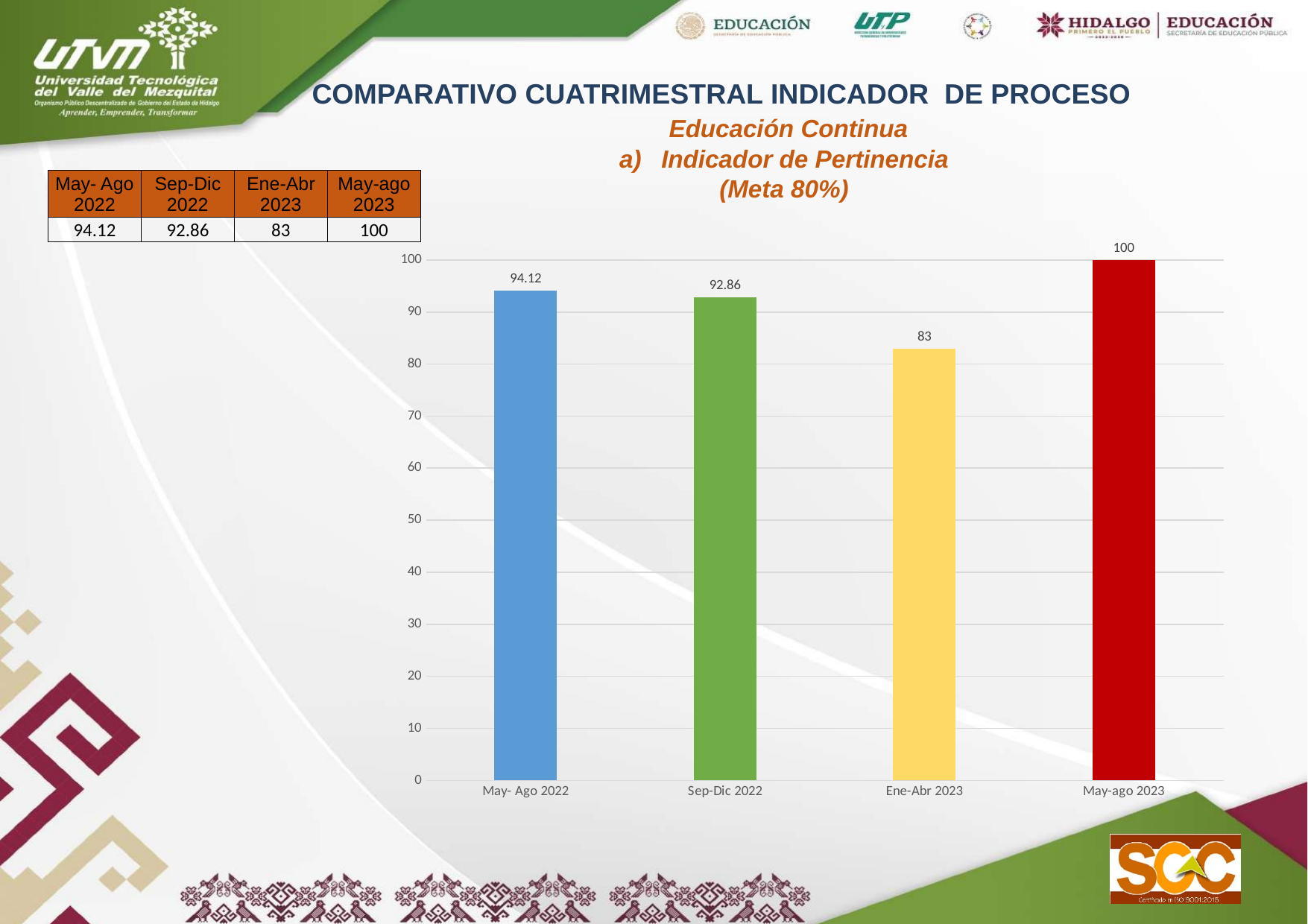
What is the difference between the values for May- Ago 2022 and Sep-Dic 2022? 1.26 What is the value for Sep-Dic 2022? 92.86 How many periods are shown on the chart? 4 Which period has the highest value? May-ago 2023 What is the difference between the values for May-ago 2023 and Ene-Abr 2023? 17 Which period has the lowest value? Ene-Abr 2023 What kind of chart is shown on the slide? Bar chart Which is larger, the value for May- Ago 2022 or the value for Ene-Abr 2023? May- Ago 2022 What is the value for May-ago 2023? 100 What is the value for May- Ago 2022? 94.12 What is the value for Ene-Abr 2023? 83 What colour is the bar for May-ago 2023? Red